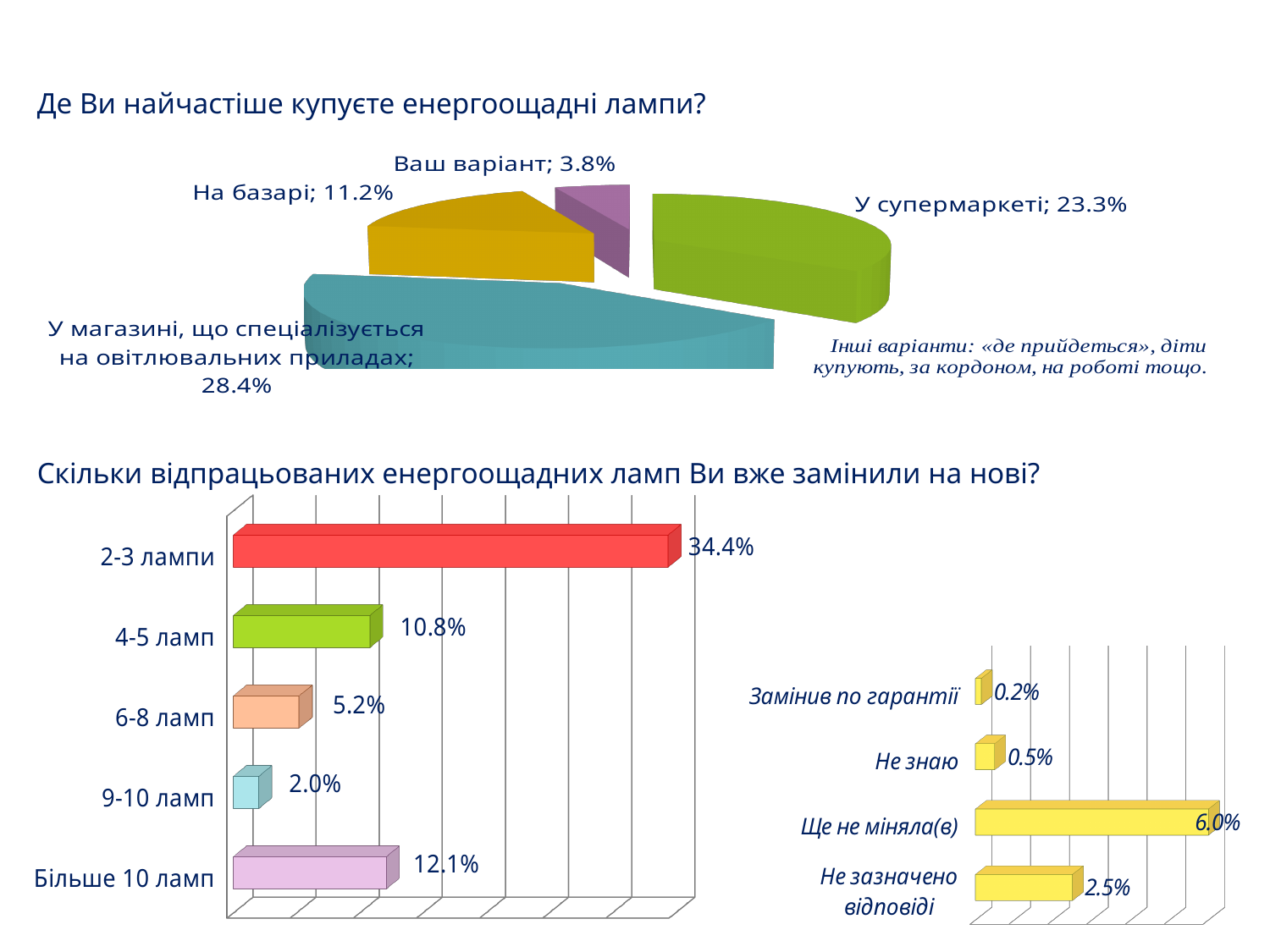
What type of chart is the top chart on the slide? Pie chart In the pie chart 'Де Ви найчастіше купуєте енергоощадні лампи?', which labelled slice has the smallest value? Ваш варіант In the yellow bar chart on the bottom right, what is the value for 'Ще не міняла(в)'? 6.0% In the bar chart 'Скільки відпрацьованих енергоощадних ламп Ви вже замінили на нові?' on the bottom left, which category has the highest value? 2-3 лампи In the bar chart on the bottom left, how many categories are shown? 5 In the bar chart 'Скільки відпрацьованих енергоощадних ламп Ви вже замінили на нові?' on the bottom left, which category has the lowest value? 9-10 ламп In the pie chart 'Де Ви найчастіше купуєте енергоощадні лампи?', what percentage is shown for 'У супермаркеті'? 23.3% In the pie chart 'Де Ви найчастіше купуєте енергоощадні лампи?', which labelled slice has the largest value? У магазині, що спеціалізується на овітлювальних приладах In the pie chart 'Де Ви найчастіше купуєте енергоощадні лампи?', what is the difference between 'У супермаркеті' and 'На базарі'? 12.1 percentage points In the bar chart 'Скільки відпрацьованих енергоощадних ламп Ви вже замінили на нові?' on the bottom left, what is the value for '4-5 ламп'? 10.8% In the bar chart on the bottom left, which is larger: 'Більше 10 ламп' or '6-8 ламп'? Більше 10 ламп In the yellow bar chart on the bottom right, what is the difference between 'Не зазначено відповіді' and 'Не знаю'? 2.0%